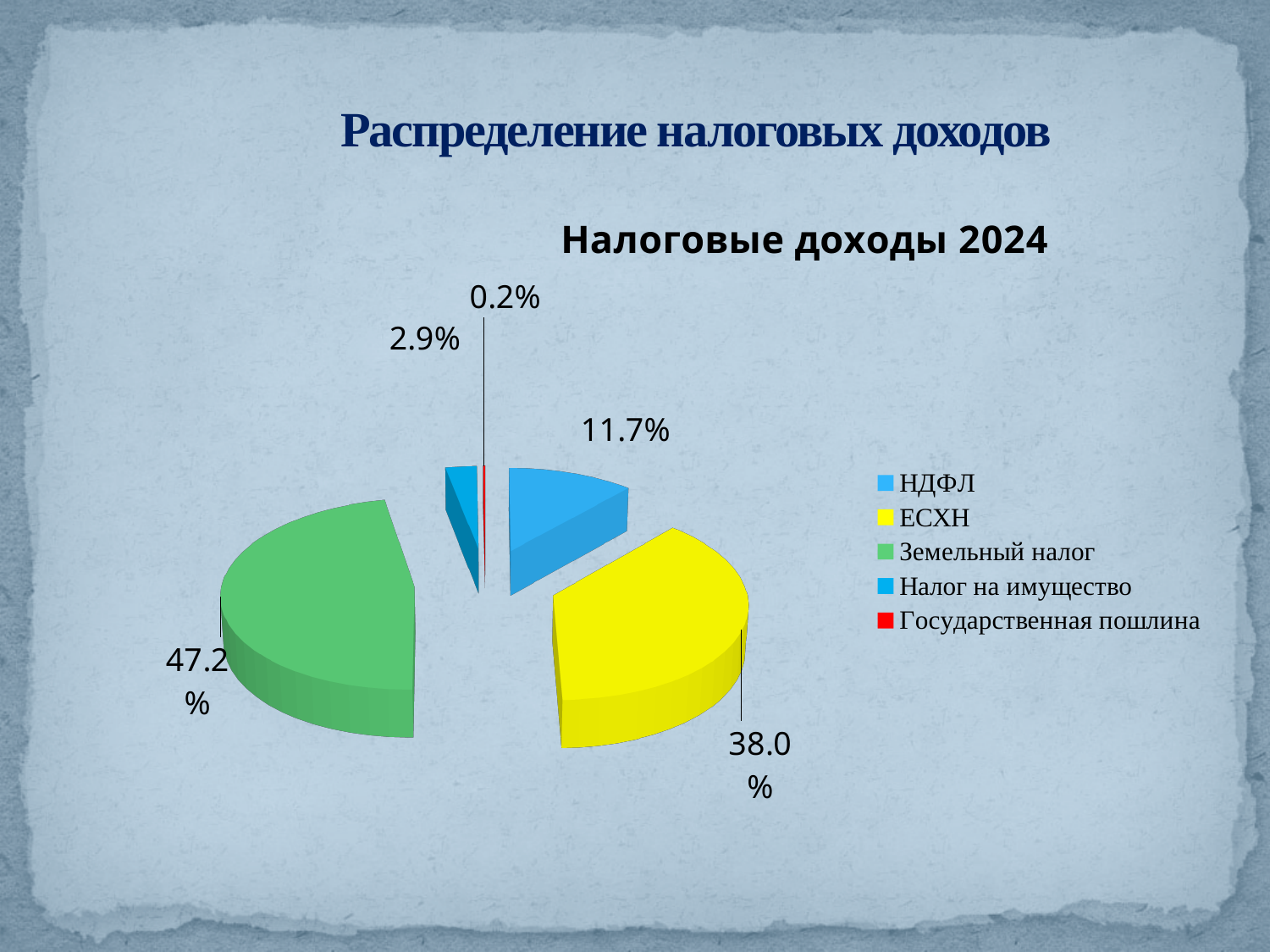
What type of chart is shown on the slide? pie chart How many categories does the legend list? 5 Which is larger, the share of ЕСХН or the share of НДФЛ? ЕСХН What share of the pie does НДФЛ have? 11.7% What is the title of the chart? Налоговые доходы 2024 What share of the pie does Земельный налог have? 47.2% What share of the pie does Государственная пошлина have? 0.2% What is the difference between the shares of Земельный налог and ЕСХН? 9.2% Which category has the largest share of the pie? Земельный налог Which category has the smallest share of the pie? Государственная пошлина